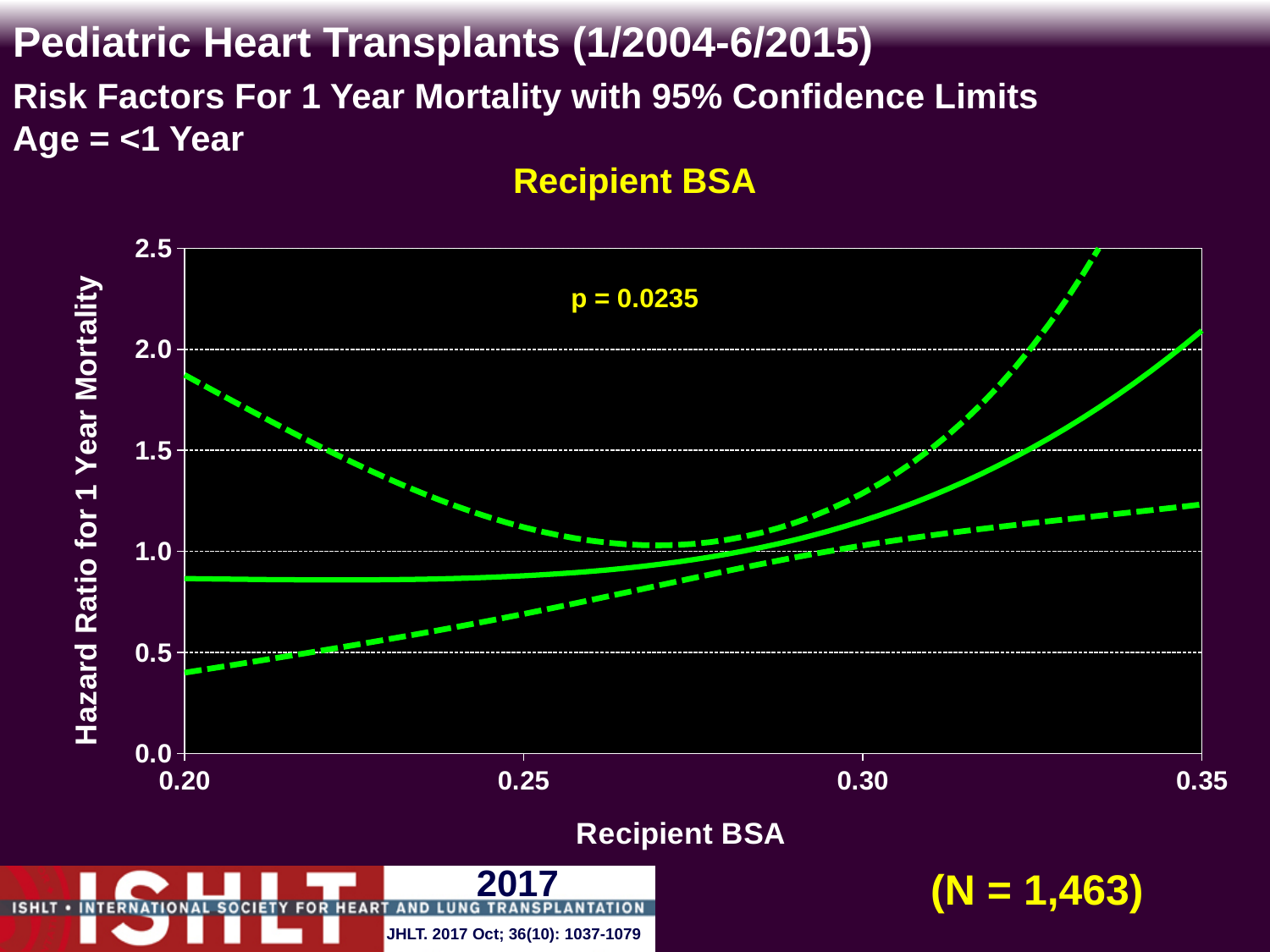
Is the lower dashed confidence limit at Recipient BSA 0.20 greater or less than 0.5? less Is the solid hazard ratio line at Recipient BSA 0.35 greater or less than 1.5? greater What is the label of the y axis? Hazard Ratio for 1 Year Mortality Is the solid hazard ratio line at Recipient BSA 0.20 greater or less than 1.0? less What p-value is printed on the chart? p = 0.0235 What is the sample size (N) shown on the slide? N = 1,463 What is the highest value shown on the y axis? 2.5 How many curves are plotted on the chart? 3 What is the title of the chart? Recipient BSA Does the solid hazard ratio line rise or fall as Recipient BSA increases from 0.30 to 0.35? rise What kind of chart is shown on the slide? line chart